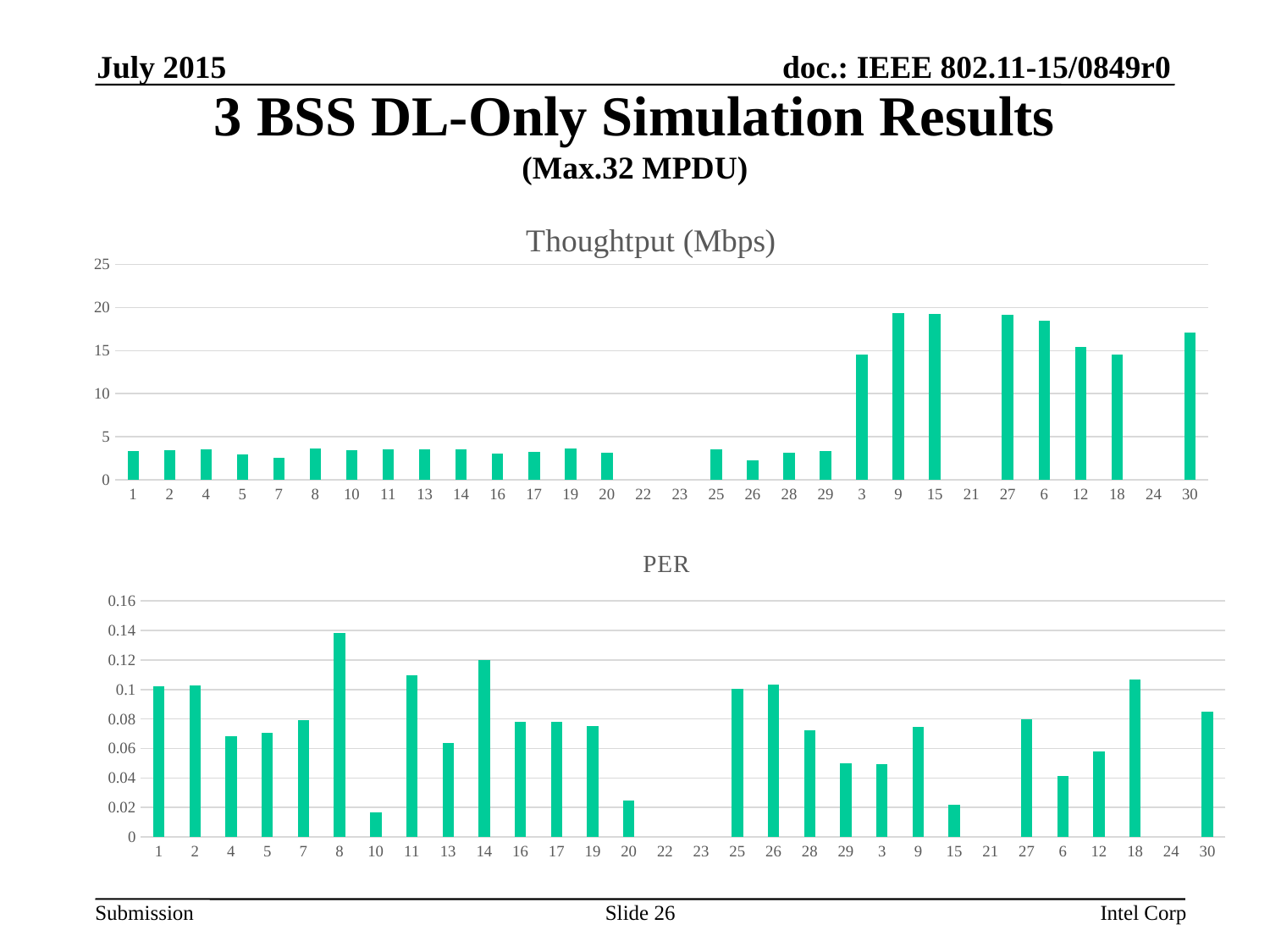
In the PER chart, is the value for category 8 greater or less than 0.12? greater In the PER chart, which category has the highest value? 8 What is the title of the top chart on the slide? Thoughtput (Mbps) In the Thoughtput (Mbps) chart, is the value for category 30 greater or less than 15? greater In the PER chart, is the value for category 14 greater or less than 0.1? greater What kind of chart is the Thoughtput (Mbps) chart? bar chart In the Thoughtput (Mbps) chart, which is larger, the value for category 9 or the value for category 26? 9 In the PER chart, which is larger, the value for category 25 or the value for category 29? 25 How many categories are shown on the x axis of the PER chart? 30